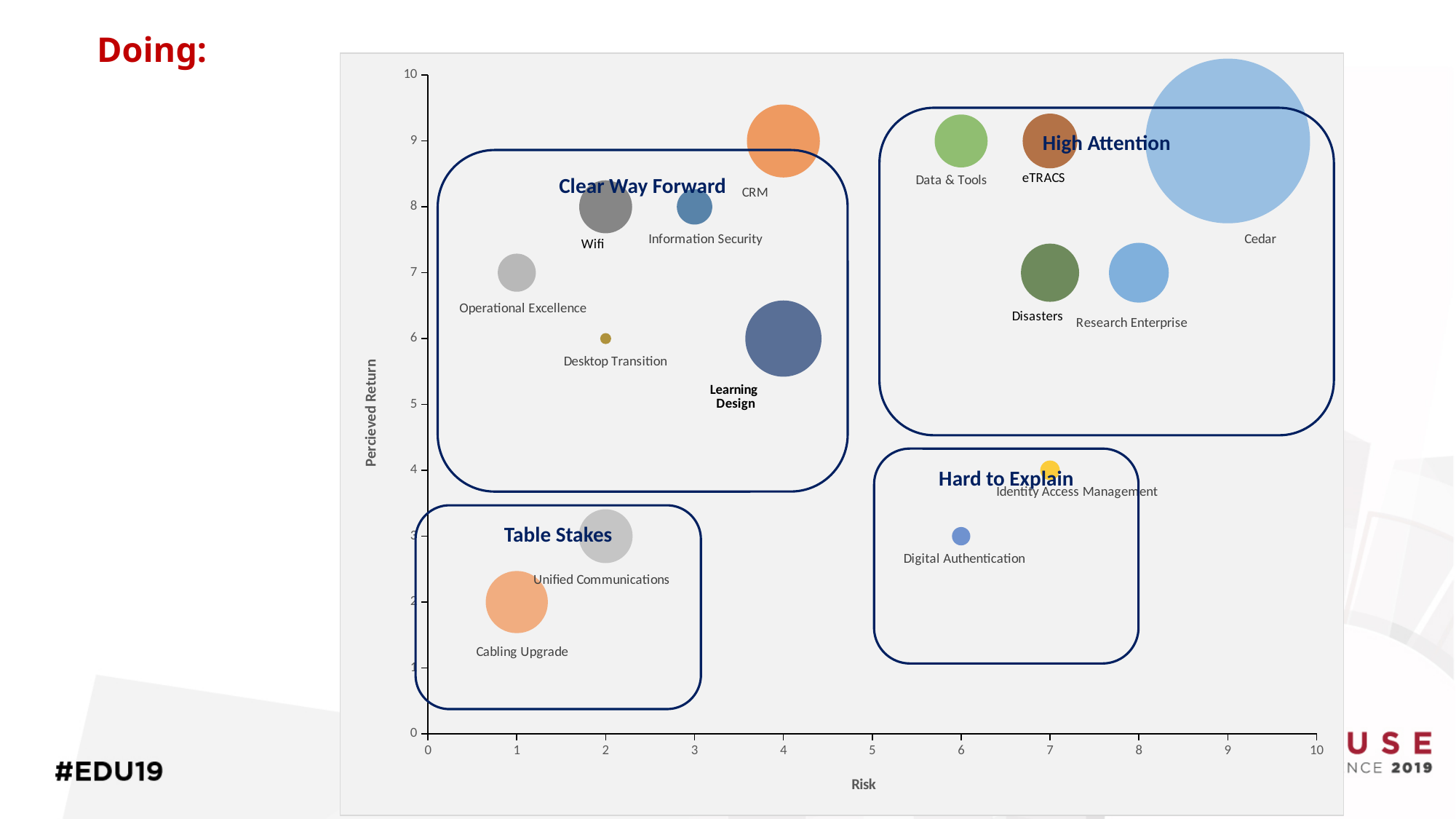
What is the title of the horizontal axis of the chart? Risk What is the Perceived Return value for Cabling Upgrade? 2 Which item has the lowest Perceived Return? Cabling Upgrade What is the Perceived Return value for Desktop Transition? 6 Which item is represented by the largest bubble on the chart? Cedar Is the Risk value for Identity Access Management greater or less than 5? greater What is the difference in Risk between Cedar and Operational Excellence? 8 Which has the higher Perceived Return, Wifi or Digital Authentication? Wifi What is the Risk value for Cedar? 9 How many bubbles are plotted on the chart? 15 What kind of chart is shown on the slide? Bubble chart Which item has the highest Risk value? Cedar